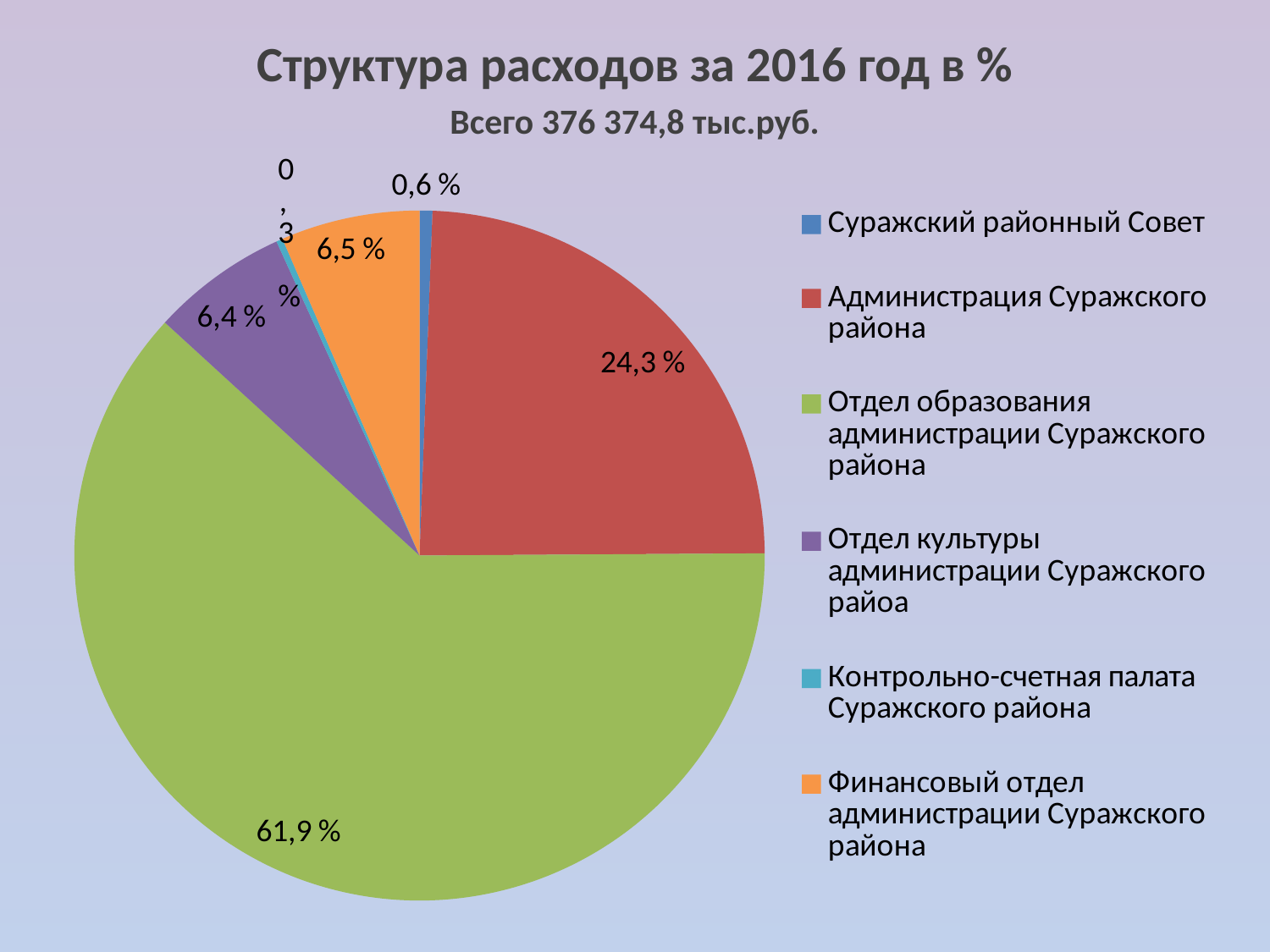
What share of expenses is attributed to Суражский районный Совет? 0,6 % What total amount is stated in the chart subtitle? 376 374,8 тыс.руб. How many slices does the pie chart have? 6 What share of expenses is attributed to Отдел образования администрации Суражского района? 61,9 % What share of expenses is attributed to Администрация Суражского района? 24,3 % Which category has the largest share of expenses? Отдел образования администрации Суражского района Which category has the smallest share of expenses? Контрольно-счетная палата Суражского района What share of expenses is attributed to Контрольно-счетная палата Суражского района? 0,3 % How many entries does the legend list? 6 What is the difference in percentage points between the shares of Отдел образования администрации Суражского района and Администрация Суражского района? 37,6 % What kind of chart is shown on the slide? pie chart What is the title of the chart? Структура расходов за 2016 год в %